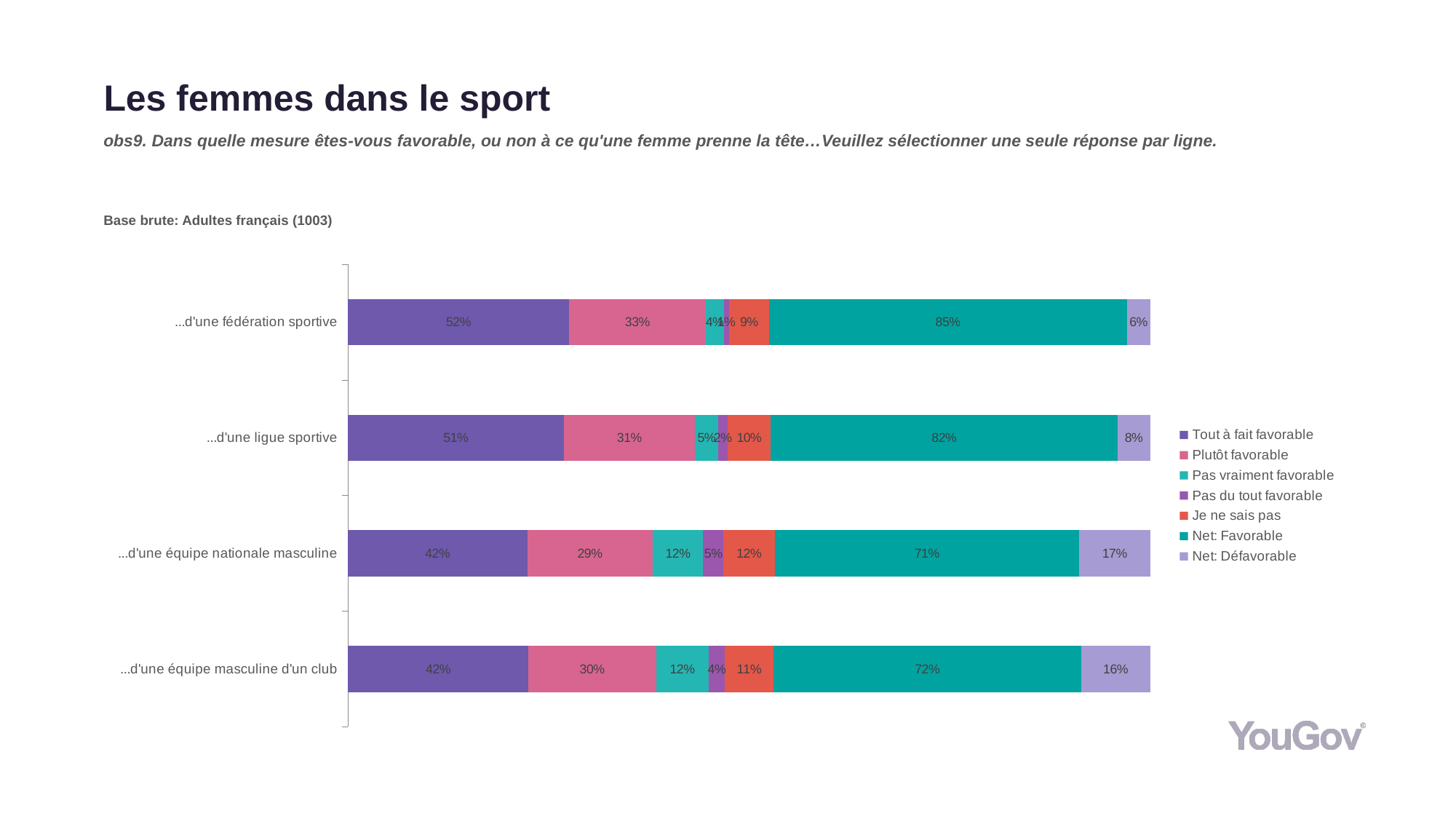
What is the base (sample) stated on the slide? Adultes français (1003) What is the 'Je ne sais pas' value for '...d'une équipe masculine d'un club'? 11% Which is larger: the 'Plutôt favorable' value for '...d'une ligue sportive' or for '...d'une équipe nationale masculine'? ...d'une ligue sportive Which category has the lowest 'Net: Défavorable' value? ...d'une fédération sportive What is the difference between the 'Net: Favorable' values for '...d'une fédération sportive' and '...d'une équipe nationale masculine'? 14% What is the 'Tout à fait favorable' value for '...d'une fédération sportive'? 52% Which category has the highest 'Net: Favorable' value? ...d'une fédération sportive How many categories are shown on the chart? 4 What is the 'Net: Défavorable' value for '...d'une équipe nationale masculine'? 17% How many series does the legend list? 7 What is the 'Net: Favorable' value for '...d'une ligue sportive'? 82% What kind of chart is shown on the slide? Stacked bar chart